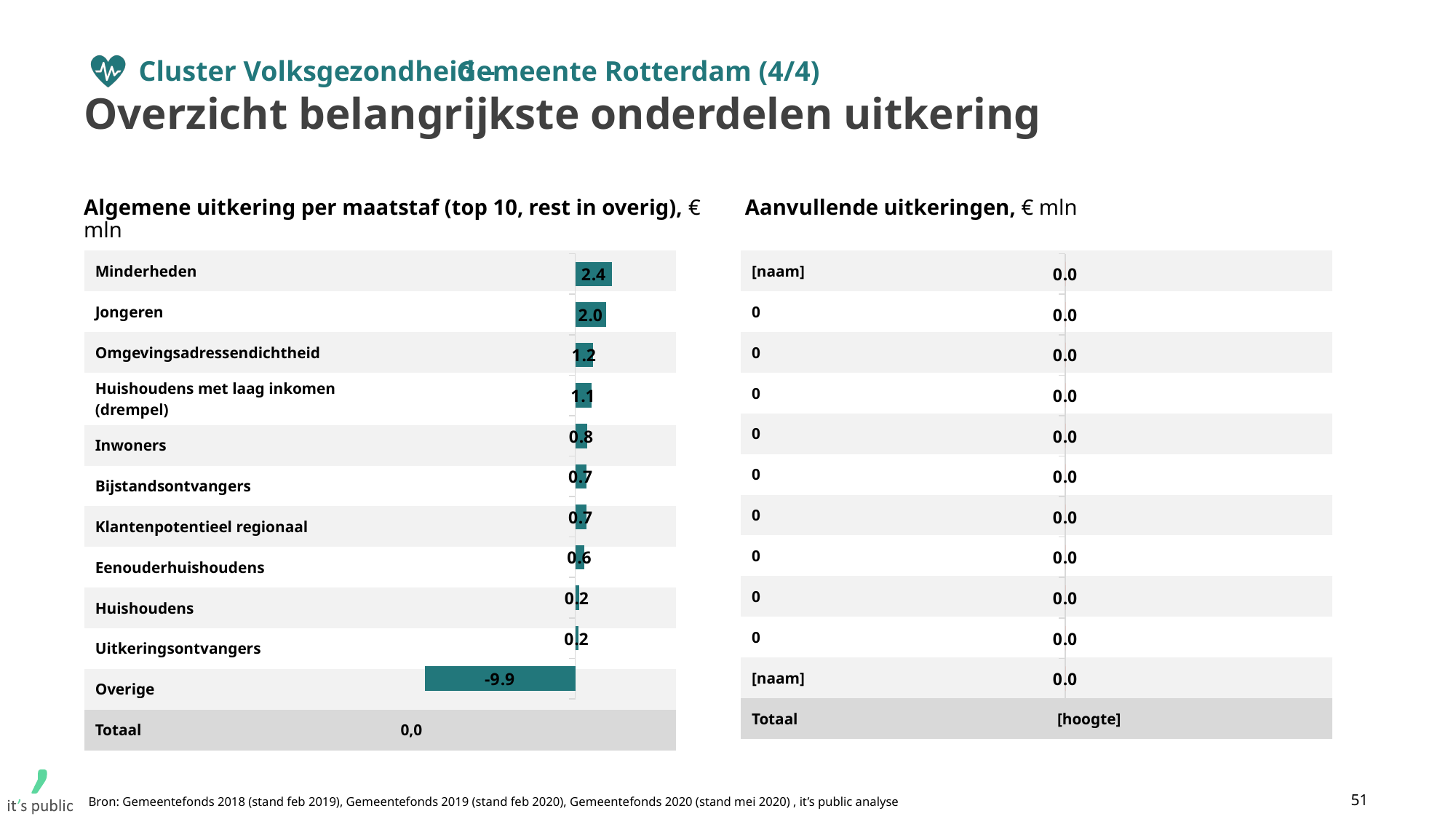
In the chart 'Algemene uitkering per maatstaf (top 10, rest in overig), € mln', what is the value for Overige? -9.9 In the chart 'Algemene uitkering per maatstaf (top 10, rest in overig), € mln', what is the value for Jongeren? 2.0 In the chart 'Algemene uitkering per maatstaf (top 10, rest in overig), € mln', which is larger: the value for Omgevingsadressendichtheid or the value for Inwoners? Omgevingsadressendichtheid In the chart 'Algemene uitkering per maatstaf (top 10, rest in overig), € mln', what is the value for Minderheden? 2.4 In the chart 'Algemene uitkering per maatstaf (top 10, rest in overig), € mln', which category has the highest value? Minderheden In the chart 'Algemene uitkering per maatstaf (top 10, rest in overig), € mln', what is the value for Eenouderhuishoudens? 0.6 In the chart 'Algemene uitkering per maatstaf (top 10, rest in overig), € mln', what is the difference between the values for Minderheden and Jongeren? 0.4 In the chart 'Algemene uitkering per maatstaf (top 10, rest in overig), € mln', which category has the lowest value? Overige In the chart 'Algemene uitkering per maatstaf (top 10, rest in overig), € mln', what is the difference between the values for Minderheden and Overige? 12.3 In the chart 'Algemene uitkering per maatstaf (top 10, rest in overig), € mln', what is the value shown in the Totaal row? 0,0 What kind of chart is 'Algemene uitkering per maatstaf (top 10, rest in overig), € mln'? bar chart In the chart 'Algemene uitkering per maatstaf (top 10, rest in overig), € mln', how many categories have bars plotted? 11